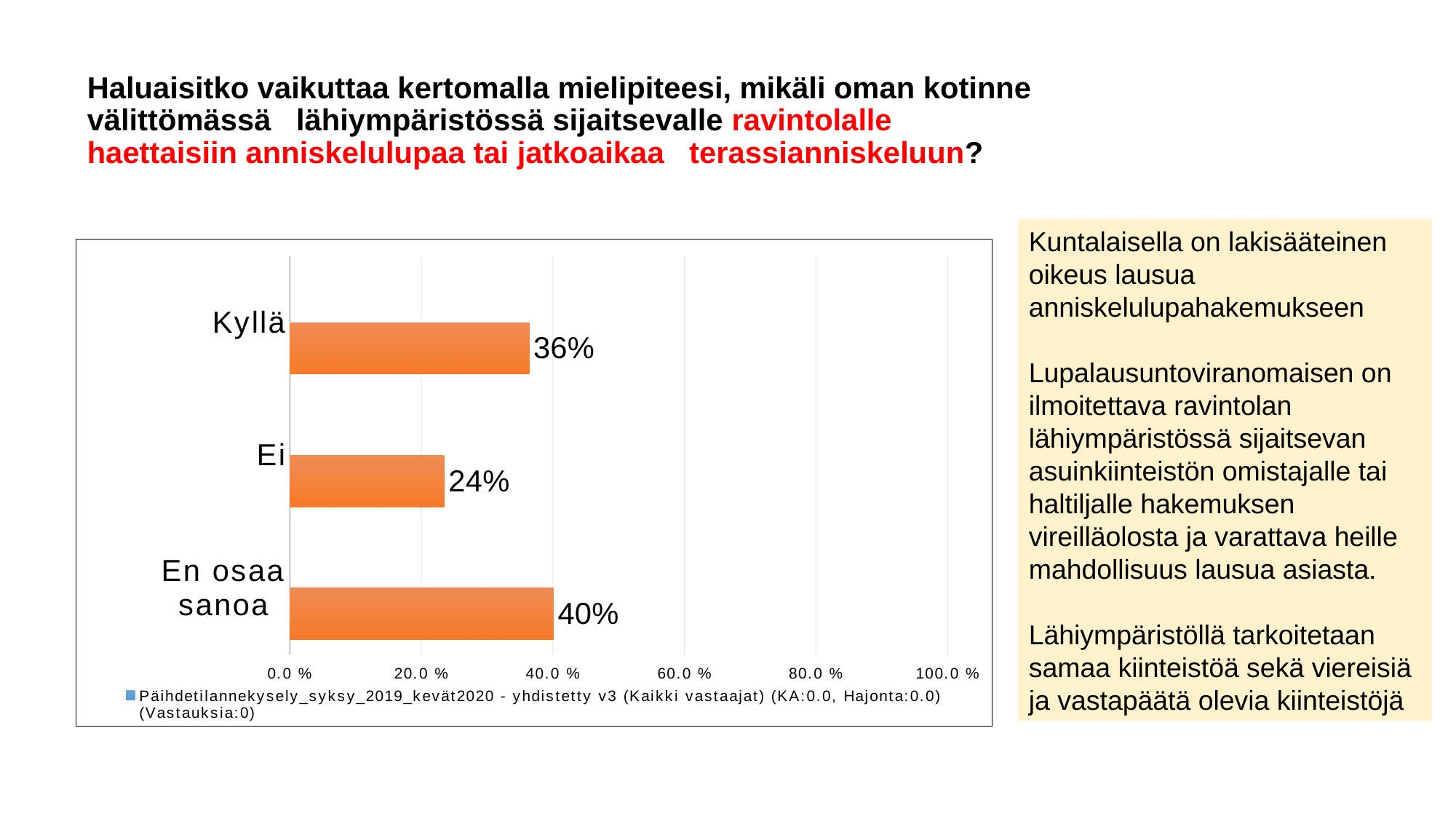
Which is larger, the value for Kyllä or the value for Ei? Kyllä What is the highest value shown on the x axis of the chart? 100.0 % Is the value for Ei greater or less than 40.0 %? less What kind of chart is shown on the slide? bar chart Which category has the highest value? En osaa sanoa Which category has the lowest value? Ei What is the value for Kyllä? 36% What is the difference between the values for En osaa sanoa and Kyllä? 4% What is the difference between the values for Kyllä and Ei? 12% What is the value for Ei? 24% What is the value for En osaa sanoa? 40% How many categories are shown in the chart? 3